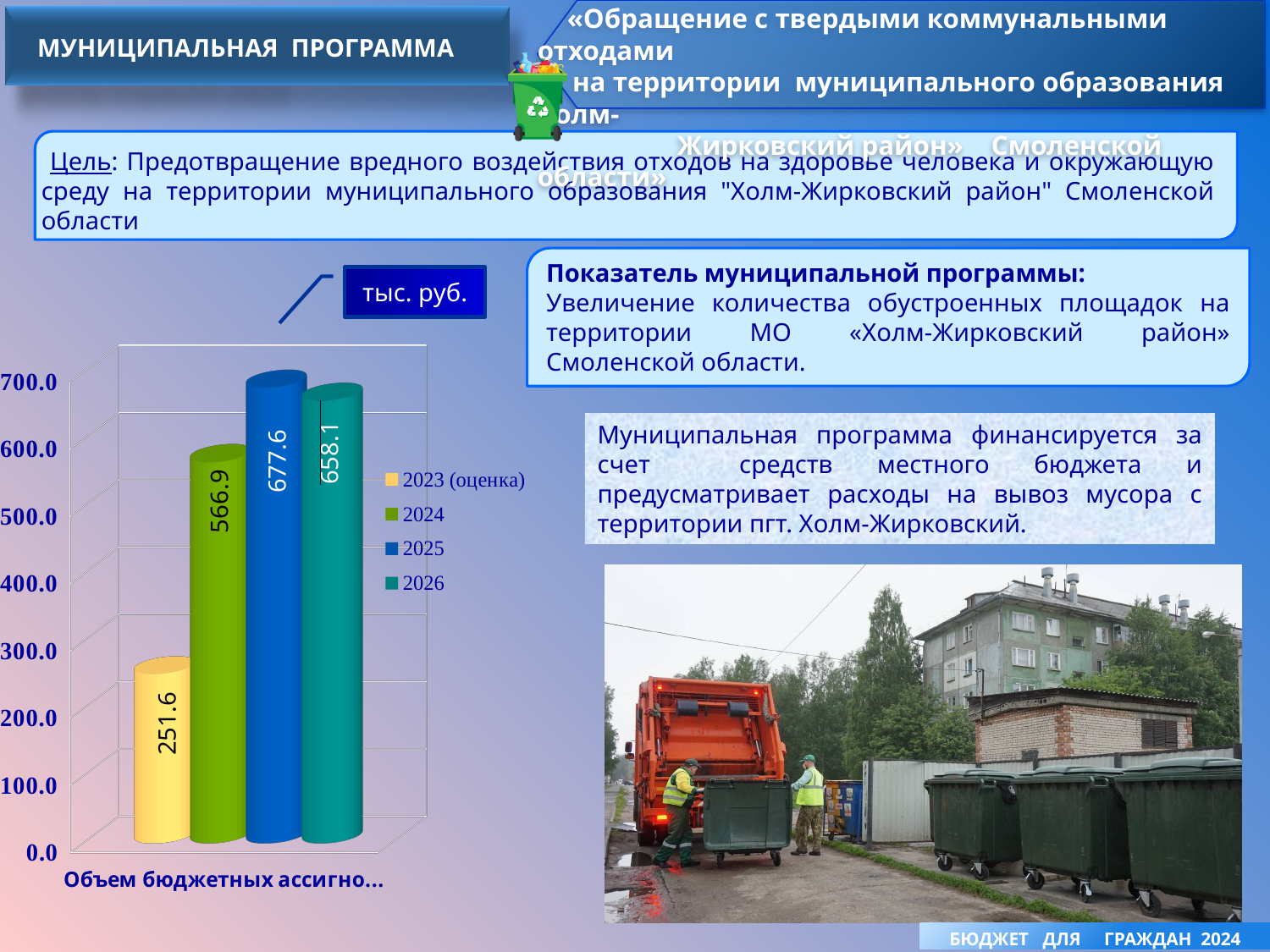
What kind of chart is shown on the slide? Bar chart What is the value for 2023 (оценка) on the chart? 251.6 What is the difference between the values for 2024 and 2023 (оценка)? 315.3 What is the value for 2025 on the chart? 677.6 What unit of measurement is indicated for the chart values? тыс. руб. What is the value for 2026 on the chart? 658.1 Which is larger, the value for 2024 or the value for 2026? 2026 What is the difference between the values for 2025 and 2026? 19.5 What is the value for 2024 on the chart? 566.9 How many series does the chart legend list? 4 Which year has the highest value on the chart? 2025 Which year has the lowest value on the chart? 2023 (оценка)